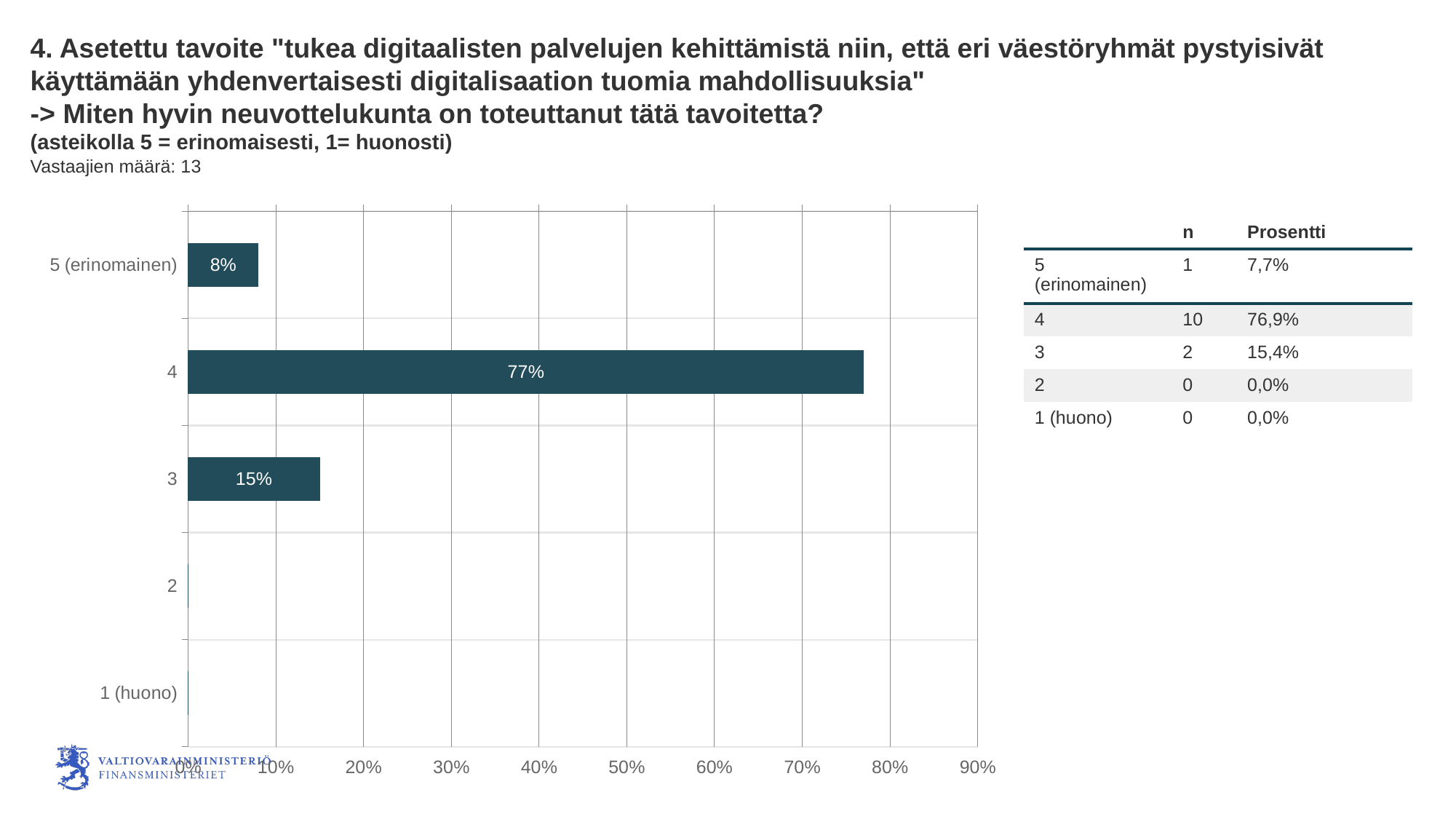
Which is larger, the value for "3" or the value for "5 (erinomainen)"? 3 What kind of chart is shown on the slide? bar chart What percentage is shown for the category "3" in the bar chart? 15% Which category has the highest value in the bar chart? 4 How many categories are shown on the vertical axis of the bar chart? 5 What is the number of respondents (Vastaajien määrä) stated on the slide? 13 According to the table, how many respondents (n) chose "4"? 10 Is the value for "4" greater or less than 70%? greater According to the table, what is the Prosentti value for "3"? 15,4% What percentage is shown for the category "5 (erinomainen)" in the bar chart? 8% What percentage is shown for the category "4" in the bar chart? 77% What is the difference in percentage points between the bars for "4" and "3"? 62